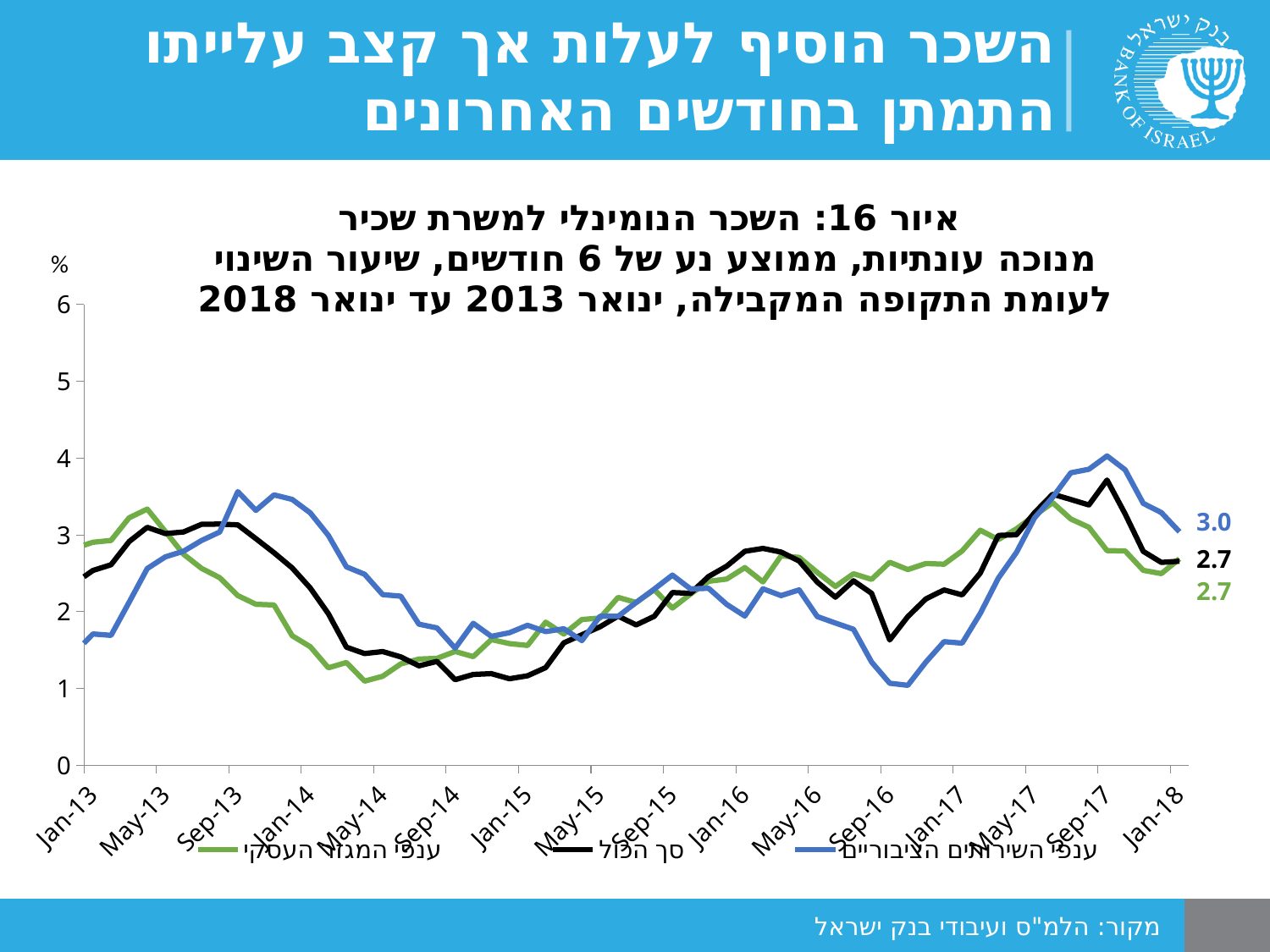
Is the value for ענפי השירותים הציבוריים at Jan-13 greater or less than 2? less What is the value labelled for סך הכל (total) at the end of the series, Jan-18? 2.7 Does the ענפי השירותים הציבוריים line rise or fall between Sep-17 and Jan-18? fall What unit is shown at the top of the vertical axis? % How many series does the legend list? 3 What is the value labelled for ענפי המגזר העסקי (business sector) at the end of the series, Jan-18? 2.7 What kind of chart is shown on the slide? line chart What is the difference between the Jan-18 values of ענפי השירותים הציבוריים and סך הכל? 0.3 Which series has the highest value at Jan-18? ענפי השירותים הציבוריים What is the value labelled for ענפי השירותים הציבוריים (public services) at the end of the series, Jan-18? 3.0 Is the value for ענפי השירותים הציבוריים at Sep-16 greater or less than 2? less